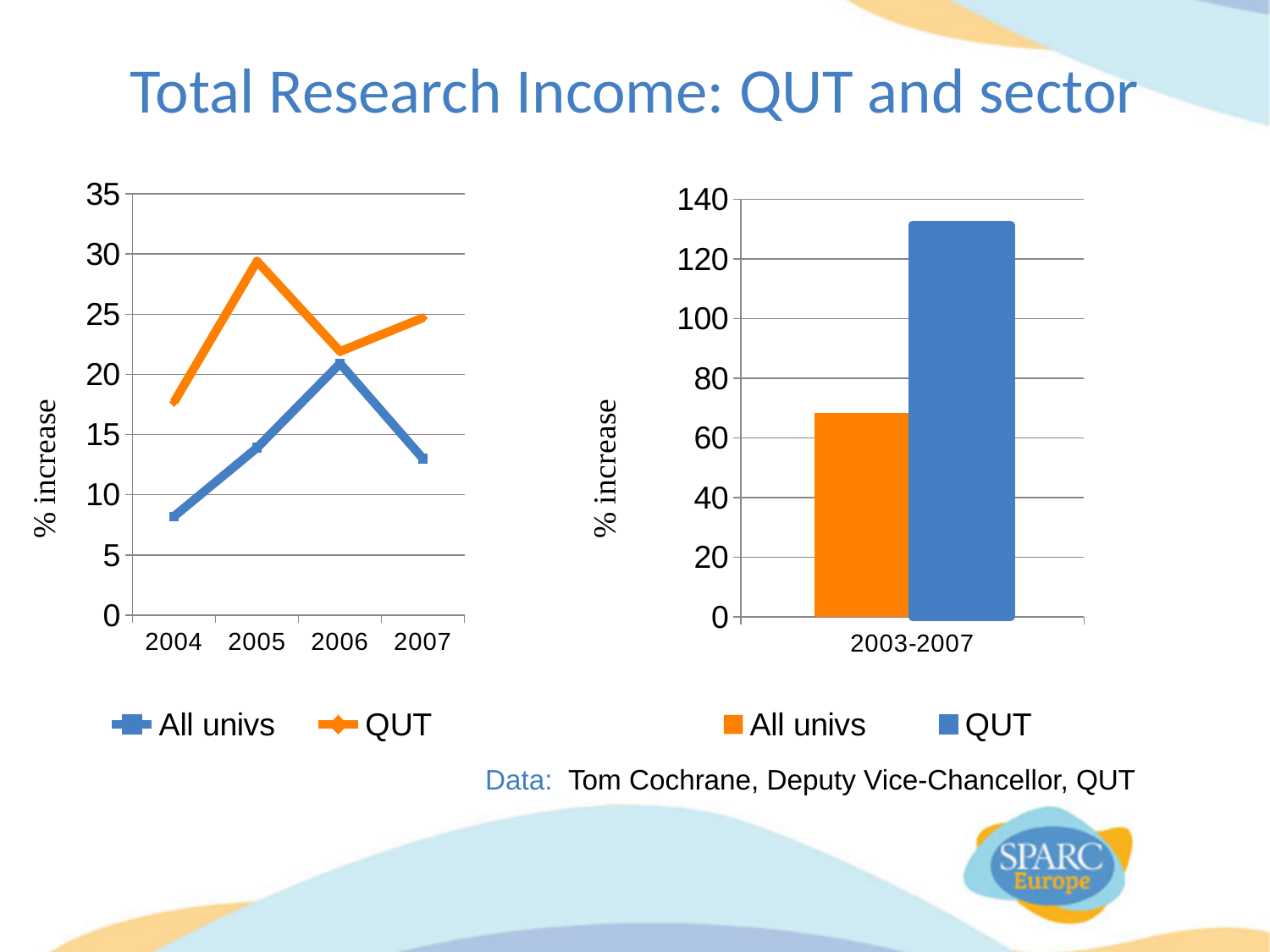
In the line chart on the left, is the All univs value for 2004 greater or less than 10? less In the line chart on the left, in which year is the All univs value highest? 2006 In the bar chart on the right, which series has the larger value for 2003-2007, All univs or QUT? QUT In the line chart on the left, in which year is the QUT value highest? 2005 In the line chart on the left, is the QUT value for 2005 greater or less than 25? greater What kind of chart is the chart on the right of the slide? bar chart In the line chart on the left, does the All univs line rise or fall from 2004 to 2006? rise In the bar chart on the right, is the QUT value greater or less than 120? greater What kind of chart is the chart on the left of the slide? line chart In the line chart on the left, how many series does the legend list? 2 In the line chart on the left, how many years are shown on the x axis? 4 In the line chart on the left, in which year is the All univs value lowest? 2004